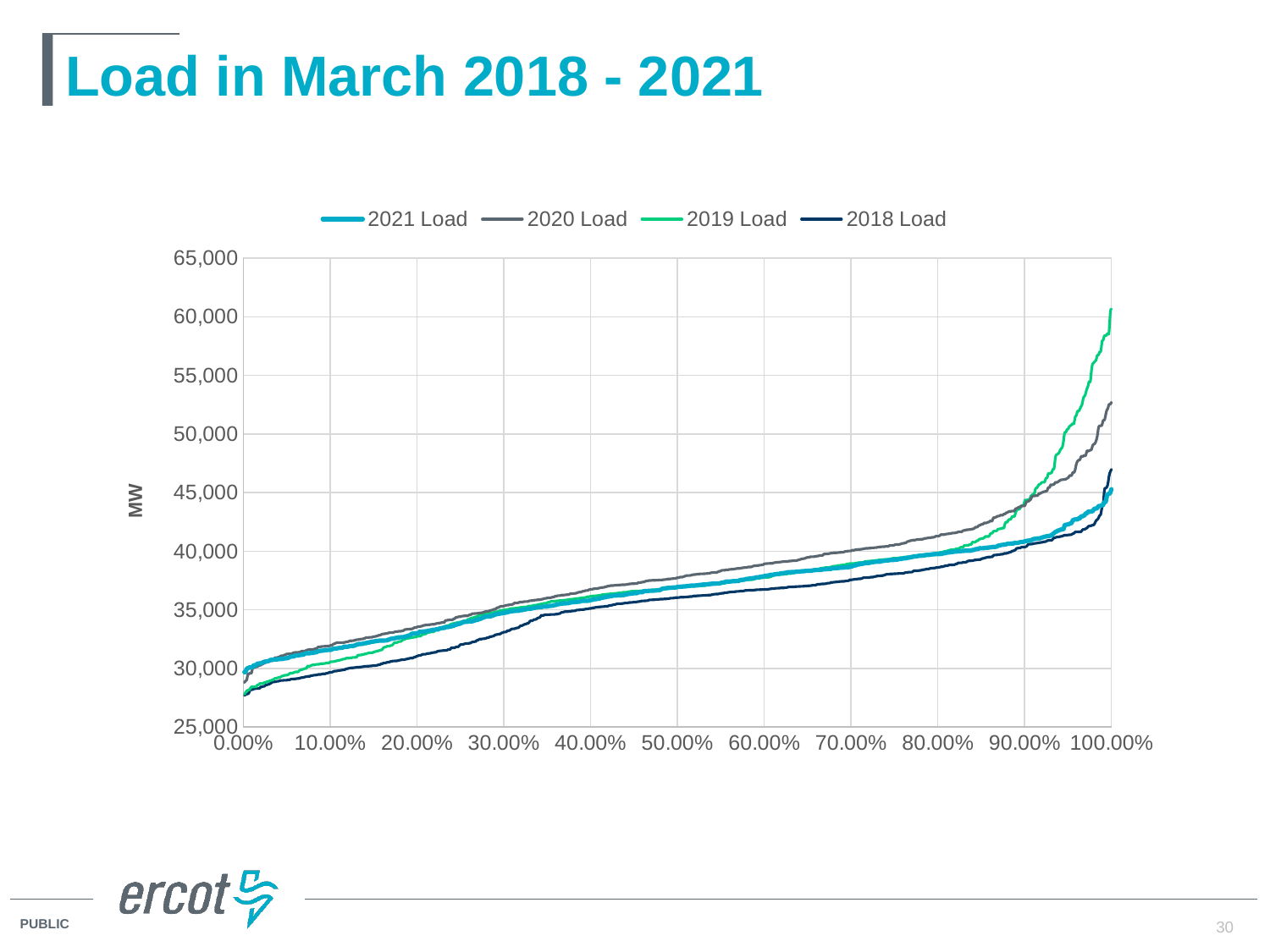
At 50.00% on the x axis, which is higher: 2020 Load or 2018 Load? 2020 Load Is the value of the 2019 Load series at 100.00% greater or less than 55,000? greater Is the value of the 2018 Load series at 0.00% greater or less than 30,000? less Which series reaches the highest value at the right end of the chart (100.00%)? 2019 Load How many series does the legend list? 4 Which series is lowest at 50.00% on the x axis? 2018 Load At 100.00% on the x axis, which is higher: 2019 Load or 2021 Load? 2019 Load Is the value of the 2021 Load series at 100.00% greater or less than 50,000? less What is the label on the vertical axis? MW Do the values of the 2021 Load series rise or fall moving from 0.00% to 100.00% along the x axis? rise What kind of chart is shown on the slide? line chart What is the title of the chart? Load in March 2018 - 2021